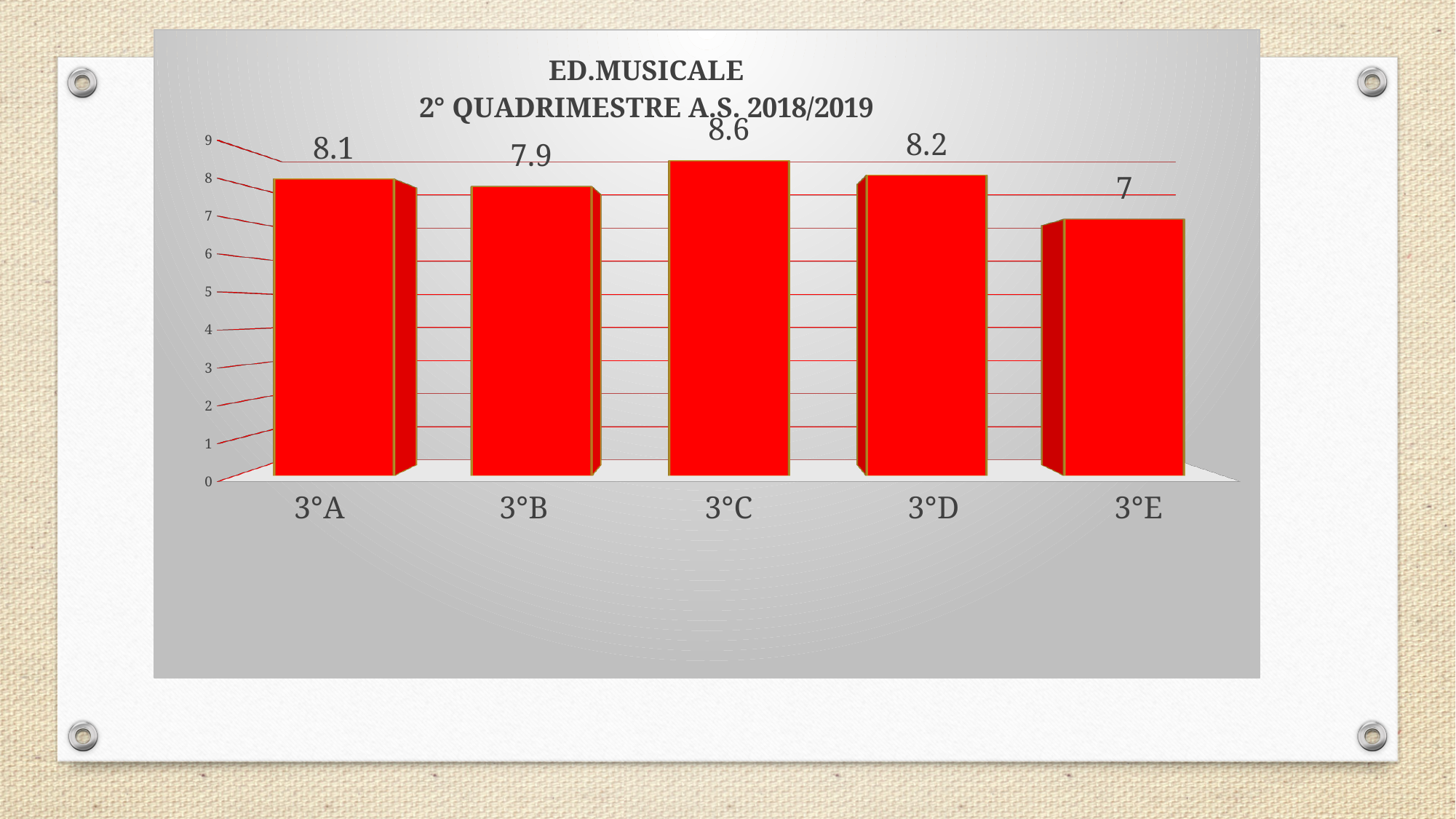
What is the value for 3°E? 7 Is the value for 3°D greater or less than 8? greater What is the title of the chart? ED.MUSICALE 2° QUADRIMESTRE A.S. 2018/2019 What is the difference between the values for 3°D and 3°B? 0.3 What is the difference between the values for 3°C and 3°E? 1.6 What kind of chart is shown on the slide? bar chart Which class has the highest value? 3°C Which class has the lowest value? 3°E Which is larger, the value for 3°A or the value for 3°B? 3°A What is the value for 3°A? 8.1 What is the value for 3°C? 8.6 How many classes are shown on the x axis? 5